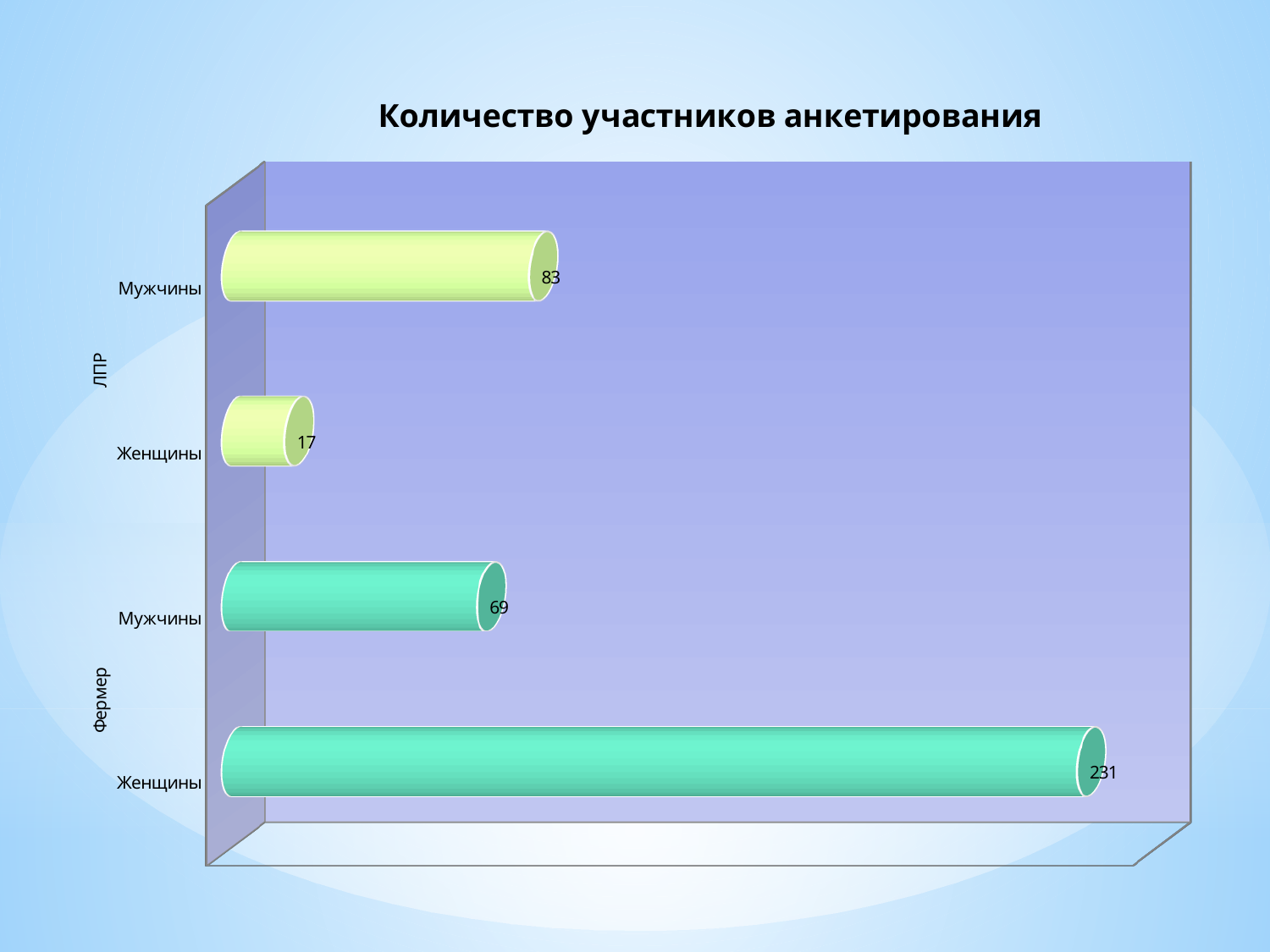
What is the value for Женщины in the ЛПР group? 17 Which bar has the highest value? Женщины (Фермер) What is the difference between Мужчины and Женщины in the ЛПР group? 66 How many bars are plotted in the chart? 4 What is the value for Женщины in the Фермер group? 231 What kind of chart is shown on the slide? bar chart What is the value for Мужчины in the Фермер group? 69 What is the title of the chart? Количество участников анкетирования Which is larger: Мужчины in the ЛПР group or Мужчины in the Фермер group? Мужчины in the ЛПР group What is the value for Мужчины in the ЛПР group? 83 What is the difference between Женщины and Мужчины in the Фермер group? 162 Which bar has the lowest value? Женщины (ЛПР)